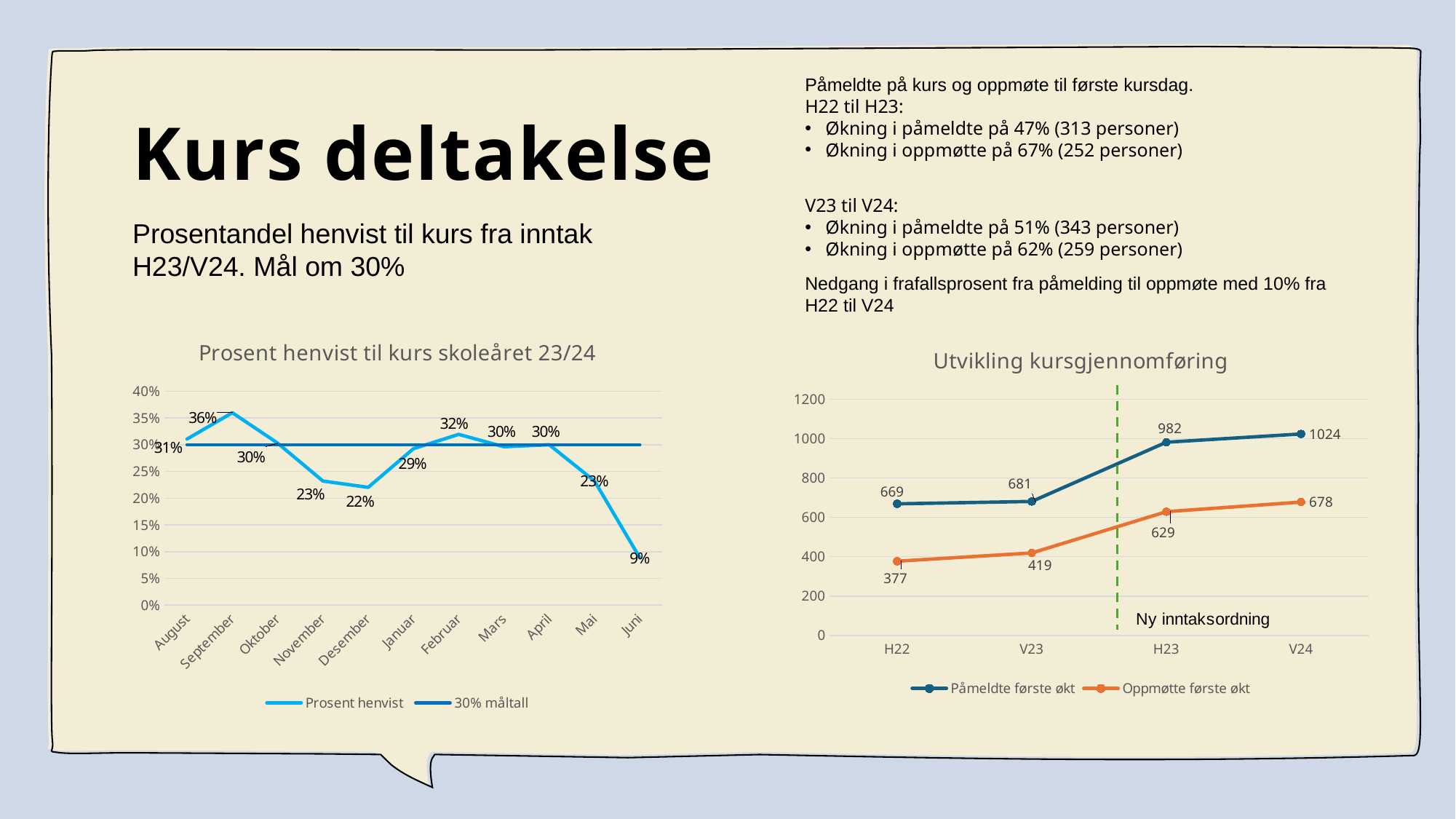
In the chart 'Prosent henvist til kurs skoleåret 23/24', which month has the highest value for Prosent henvist? September In the chart 'Prosent henvist til kurs skoleåret 23/24', what kind of chart is it? Line chart In the chart 'Utvikling kursgjennomføring', what is the value for Oppmøtte første økt at V23? 419 In the chart 'Utvikling kursgjennomføring', how many series does the legend list? 2 In the chart 'Utvikling kursgjennomføring', what label is written next to the dashed green vertical line? Ny inntaksordning In the chart 'Prosent henvist til kurs skoleåret 23/24', what is the difference between the values for Februar and Desember? 10% In the chart 'Prosent henvist til kurs skoleåret 23/24', how many months are shown on the x axis? 11 In the chart 'Utvikling kursgjennomføring', does the Oppmøtte første økt series rise or fall from H22 to V24? Rise In the chart 'Prosent henvist til kurs skoleåret 23/24', what is the value for September? 36% In the chart 'Prosent henvist til kurs skoleåret 23/24', which month has the lowest value for Prosent henvist? Juni In the chart 'Utvikling kursgjennomføring', what is the difference between Påmeldte første økt and Oppmøtte første økt at V24? 346 In the chart 'Utvikling kursgjennomføring', what is the value for Påmeldte første økt at H23? 982